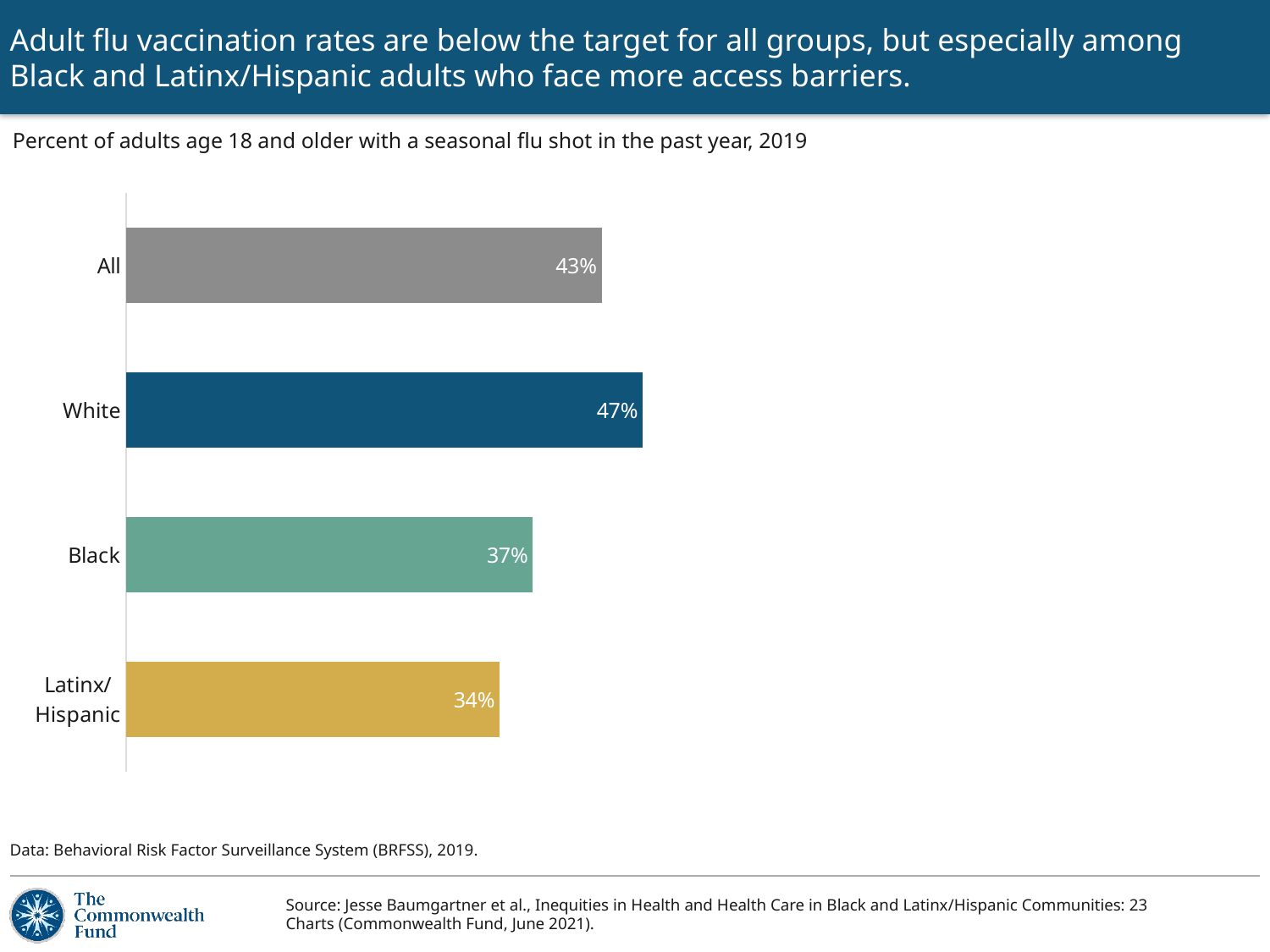
What is the difference in percentage points between the flu vaccination rates of White adults and Latinx/Hispanic adults? 13 percentage points Which group has a higher flu vaccination rate, Black adults or Latinx/Hispanic adults? Black What is the flu vaccination rate shown for White adults? 47% What percent of all adults age 18 and older had a seasonal flu shot in the past year? 43% What is the flu vaccination rate shown for Black adults? 37% What data source is cited for the chart? Behavioral Risk Factor Surveillance System (BRFSS), 2019 What is the difference in percentage points between the flu vaccination rates of White adults and Black adults? 10 percentage points Which group has the highest flu vaccination rate? White What type of chart is shown on the slide? Bar chart How many groups are shown in the chart? 4 Which group has the lowest flu vaccination rate? Latinx/Hispanic What is the flu vaccination rate shown for Latinx/Hispanic adults? 34%